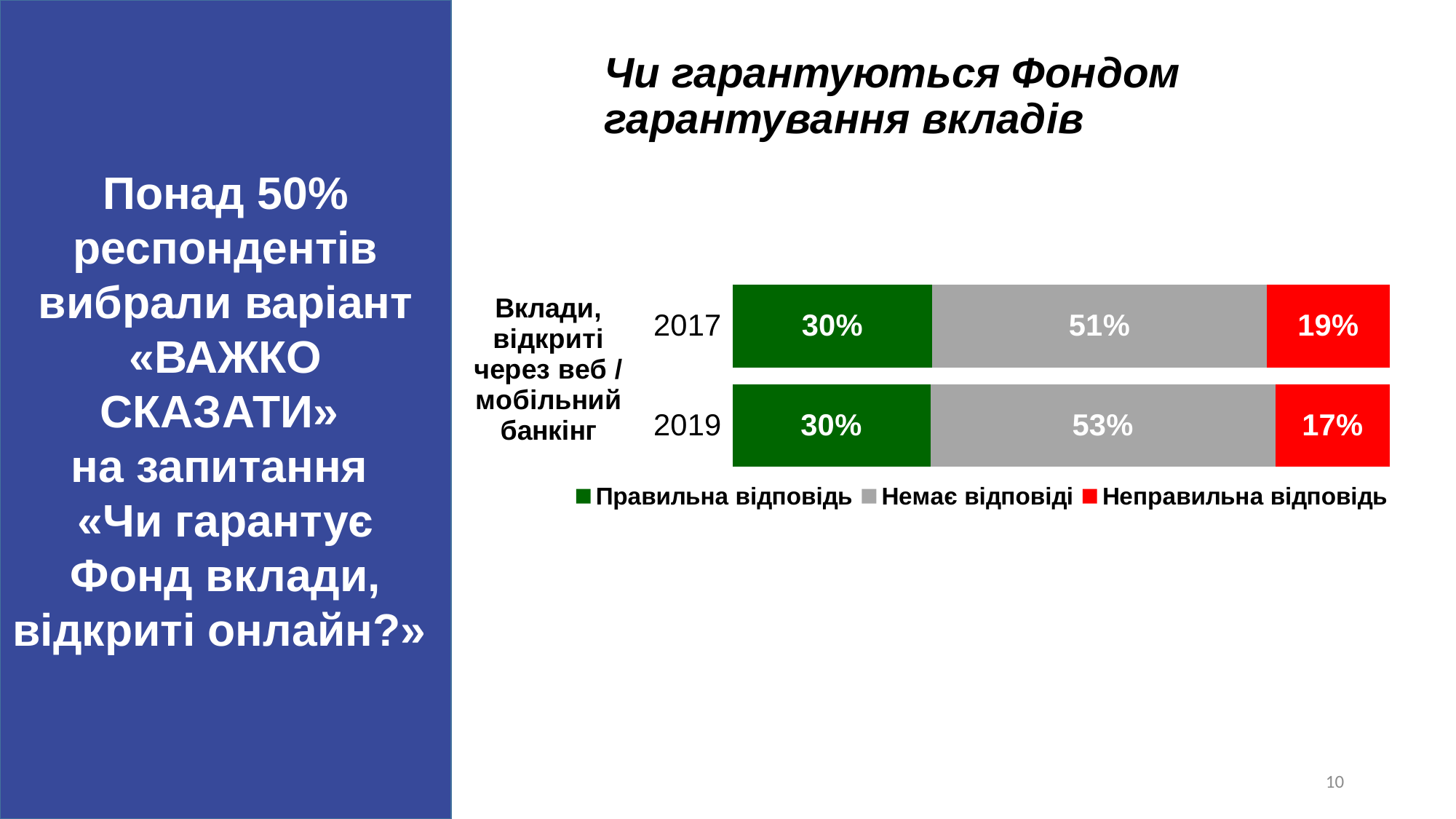
Which series has the highest value in 2019? Немає відповіді Is the "Неправильна відповідь" value larger in 2017 or in 2019? 2017 What is the value of "Правильна відповідь" for 2017? 30% Which series has the lowest value in 2017? Неправильна відповідь What is the value of "Неправильна відповідь" for 2019? 17% What kind of chart is shown on the slide? Stacked bar chart What is the value of "Неправильна відповідь" for 2017? 19% What colour represents "Правильна відповідь" in the chart? Green How many categories (years) are shown in the chart? 2 What is the difference between the "Немає відповіді" values for 2019 and 2017? 2% What is the value of "Немає відповіді" for 2019? 53% How many series does the legend list? 3